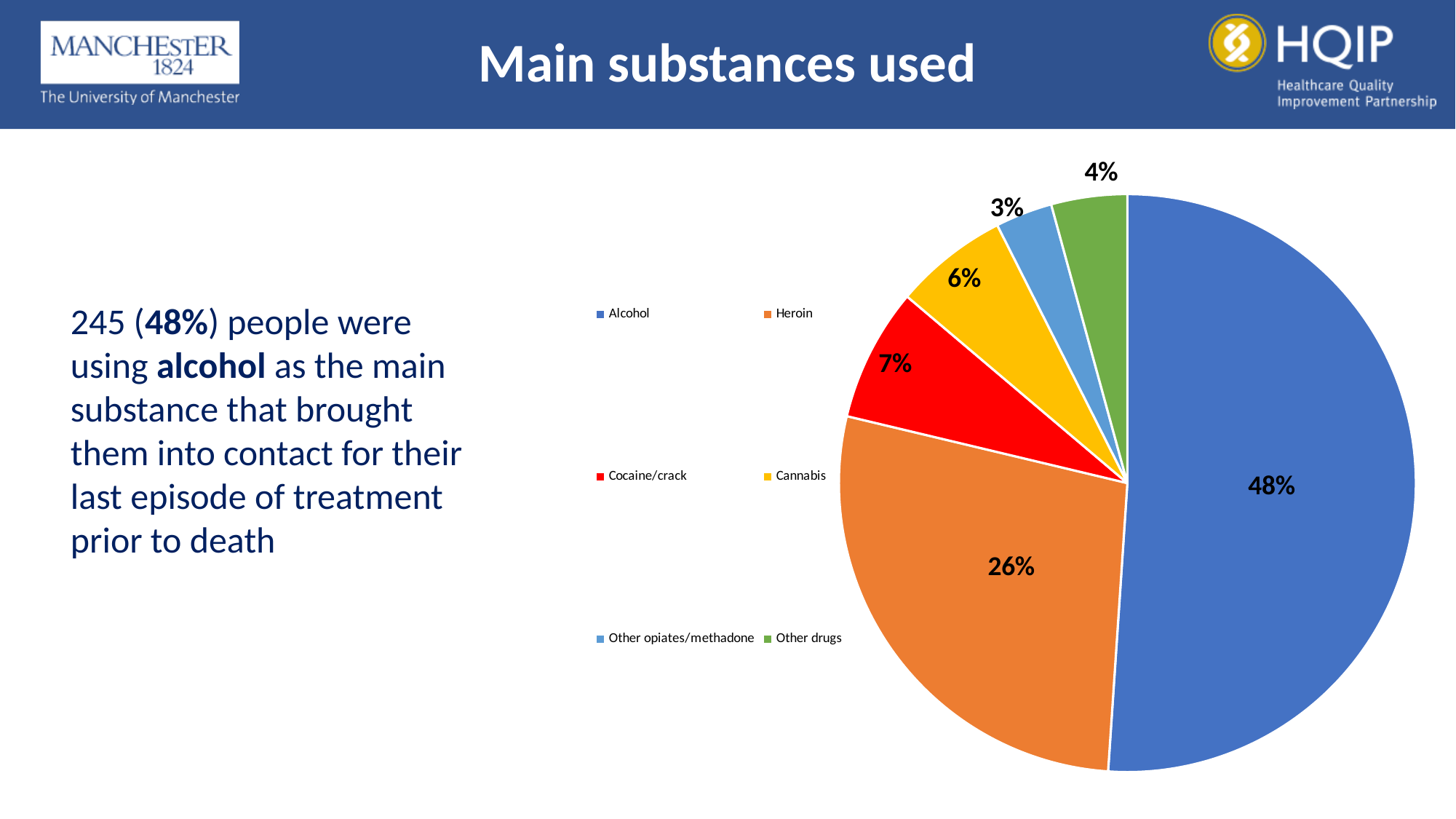
Which substance has the smallest slice of the pie? Other opiates/methadone How many categories does the legend list? 6 What type of chart is shown on the slide? Pie chart What share of the pie does Alcohol account for? 48% What share of the pie does Cocaine/crack account for? 7% What share of the pie does Cannabis account for? 6% What is the difference in percentage points between the Alcohol and Heroin slices? 22 Which substance has the largest slice of the pie? Alcohol Which slice is larger, Cocaine/crack or Cannabis? Cocaine/crack